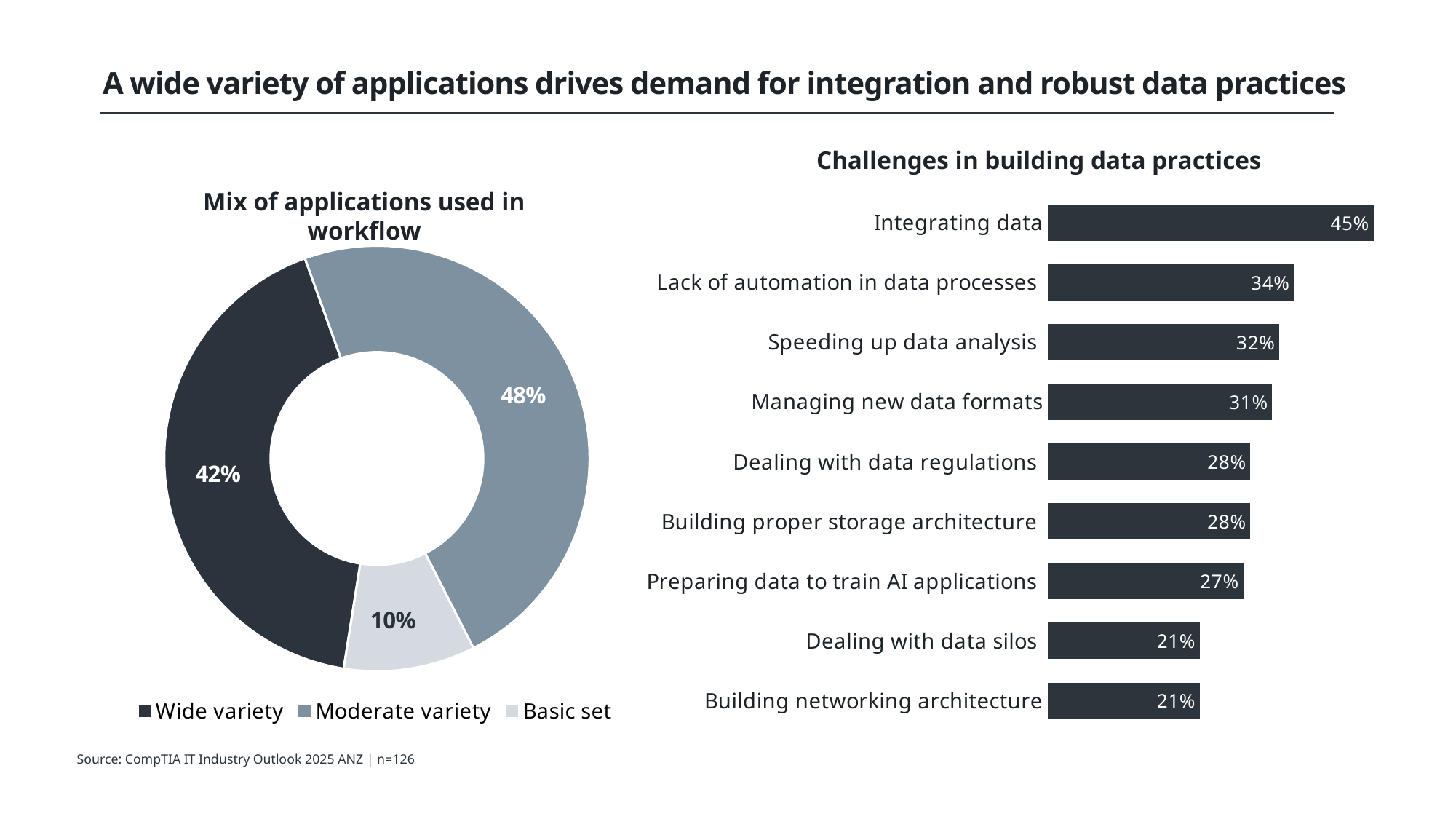
In the 'Challenges in building data practices' chart, which challenge has the highest value? Integrating data What kind of chart is 'Mix of applications used in workflow'? Doughnut chart In the 'Challenges in building data practices' chart, which is larger: Managing new data formats or Dealing with data silos? Managing new data formats In the 'Mix of applications used in workflow' chart, what is the difference between the Moderate variety and Wide variety shares? 6% What kind of chart is 'Challenges in building data practices'? Bar chart In the 'Challenges in building data practices' chart, what is the difference between Integrating data and Lack of automation in data processes? 11% In the 'Mix of applications used in workflow' chart, what share is labelled for Moderate variety? 48% In the 'Mix of applications used in workflow' chart, how many categories does the legend list? 3 How many challenges are listed in the 'Challenges in building data practices' chart? 9 In the 'Mix of applications used in workflow' chart, which category has the smallest share? Basic set In the 'Challenges in building data practices' chart, what is the value for Preparing data to train AI applications? 27% In the 'Challenges in building data practices' chart, what is the value for Speeding up data analysis? 32%